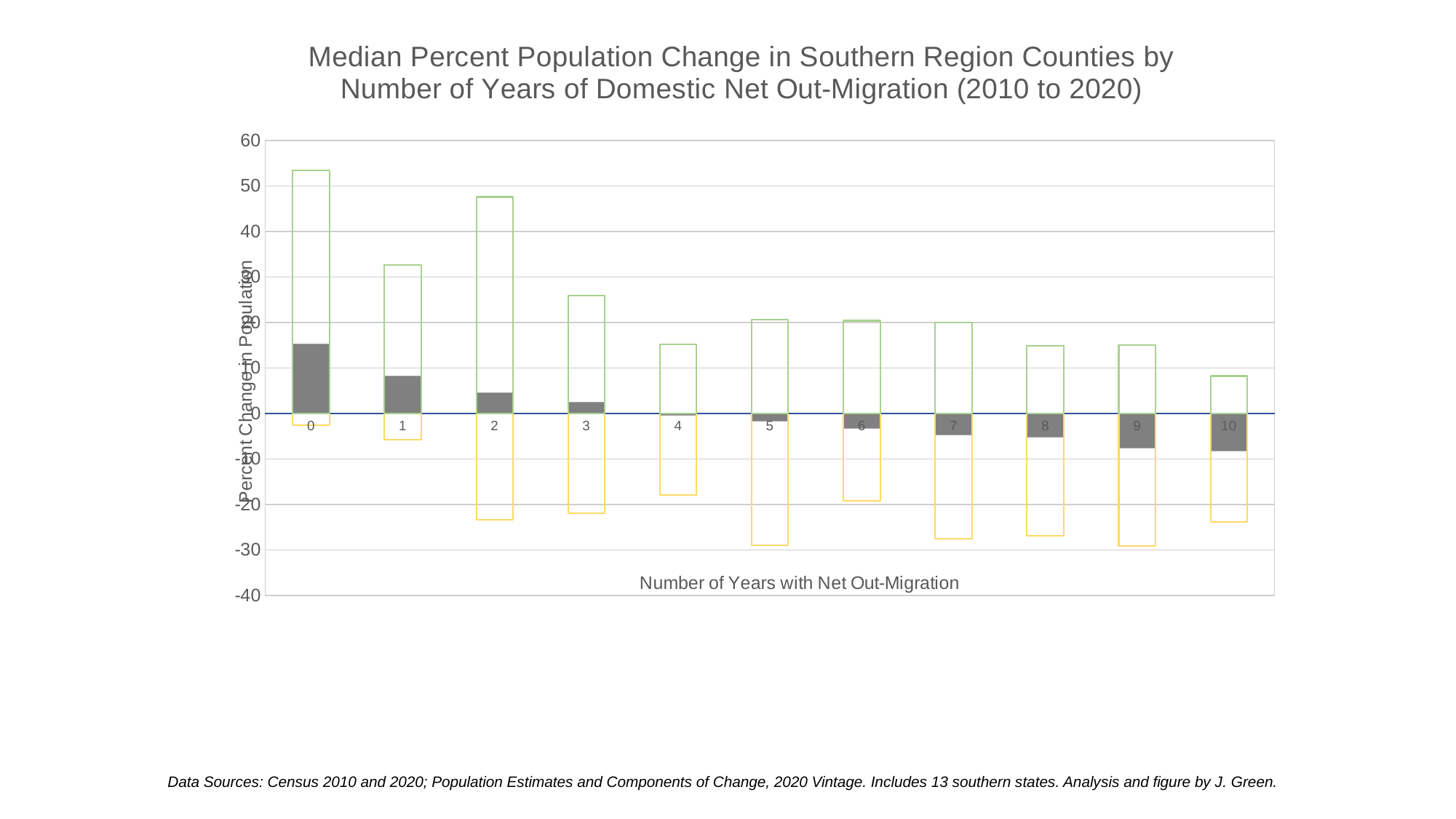
Is the gray median bar for 10 years with net out-migration greater or less than 0? less Do the gray median bars rise or fall as the number of years with net out-migration increases from 0 to 10? fall What is the label of the y axis? Percent Change in Population Which number of years with net out-migration has the highest median percent population change (tallest gray bar)? 0 Is the gray median bar for 0 years with net out-migration greater or less than 10? greater How many categories (numbers of years with net out-migration) are shown on the x axis? 11 What kind of chart is shown on the slide? bar chart Is the bottom of the yellow outlined bar for 9 years with net out-migration greater or less than -20? less Which has the larger gray median bar: 0 years or 1 year with net out-migration? 0 years What is the label of the x axis? Number of Years with Net Out-Migration